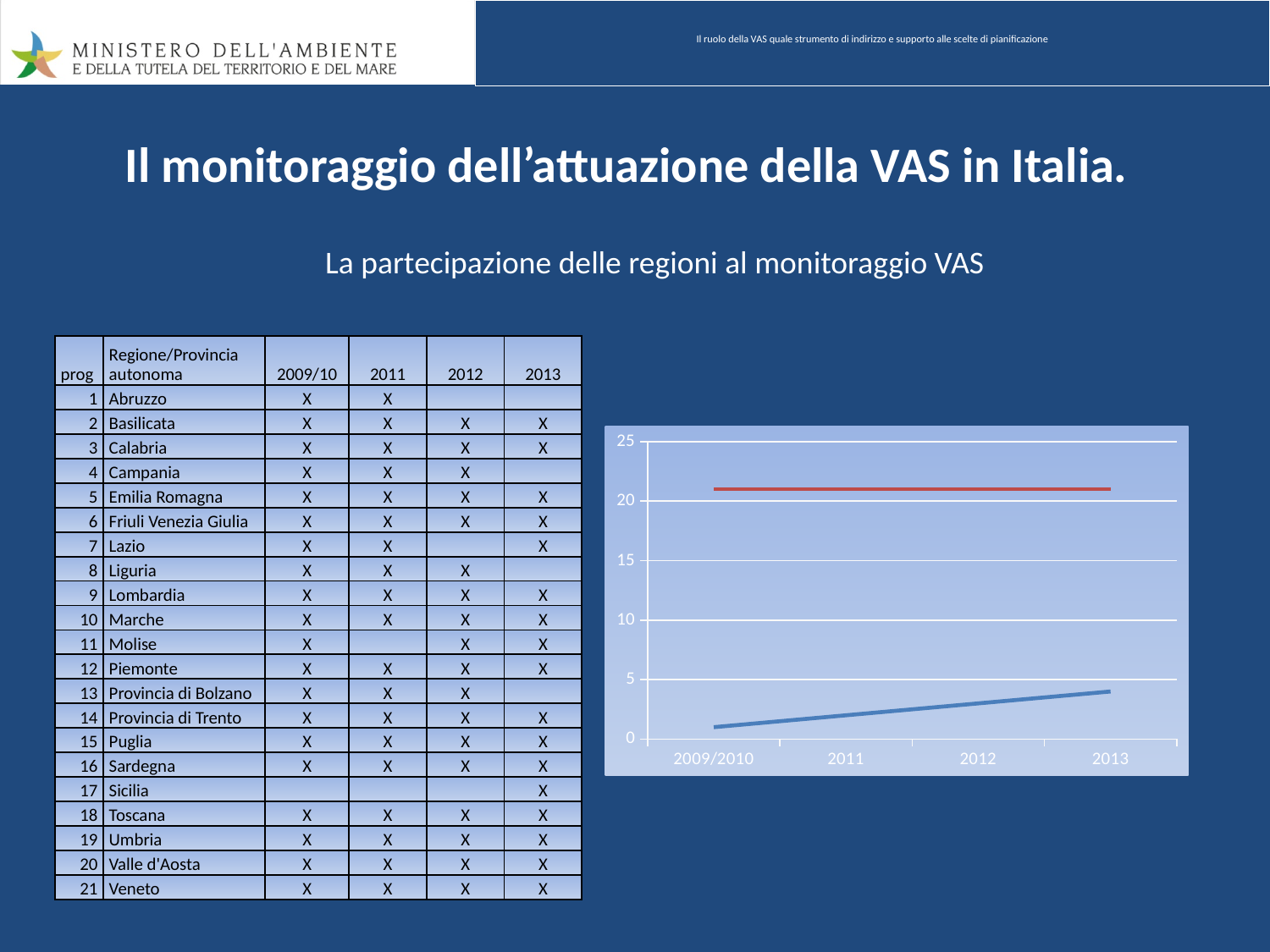
Is the value of the red line greater or less than 20? greater Is the value of the blue line at 2009/2010 greater or less than 5? less Is the value of the blue line at 2013 greater or less than 5? less What kind of chart is shown on the right of the slide? line chart At 2013, which line has the larger value, the red line or the blue line? the red line How many points are labelled along the x axis of the chart? 4 Does the blue line rise or fall from 2009/2010 to 2013? rise At which x-axis point does the blue line reach its highest value? 2013 How many lines are plotted in the chart? 2 What is the highest value shown on the chart's y axis? 25 Does the red line rise, fall or stay flat across the x axis? stay flat At which x-axis point does the blue line have its lowest value? 2009/2010